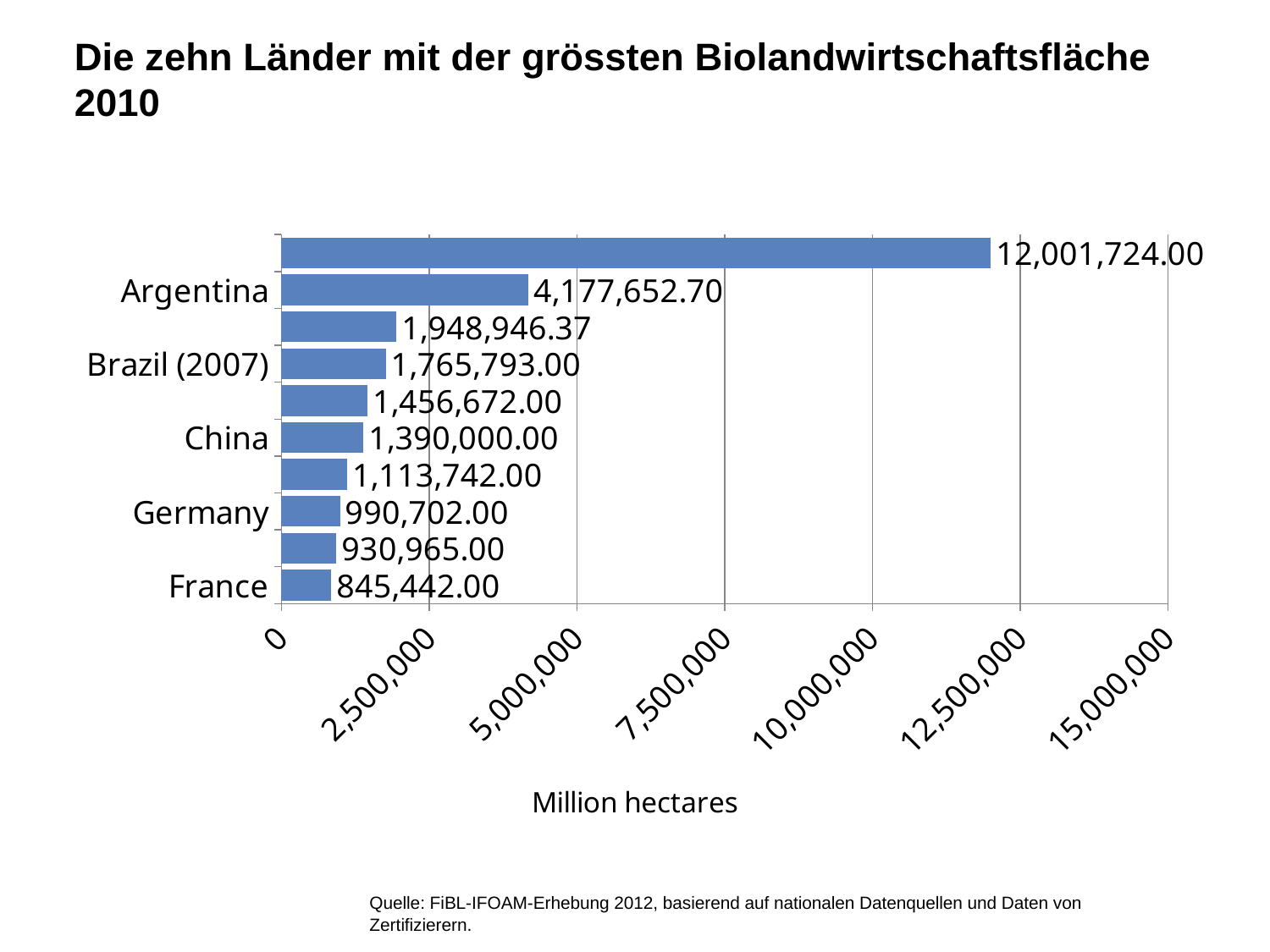
What is the value for Argentina? 4,177,652.70 What is the value for France? 845,442.00 Which labelled country has the lowest value? France What is the difference between the values for Germany and France? 145,260.00 Is the value for Argentina greater or less than 2,500,000? greater Which is larger, the value for Argentina or the value for China? Argentina What is the value for Germany? 990,702.00 What is the difference between the values for Argentina and Brazil (2007)? 2,411,859.70 How many bars are shown on the chart? 10 What is the value for China? 1,390,000.00 What is the value for Brazil (2007)? 1,765,793.00 What is the largest value shown on the chart? 12,001,724.00